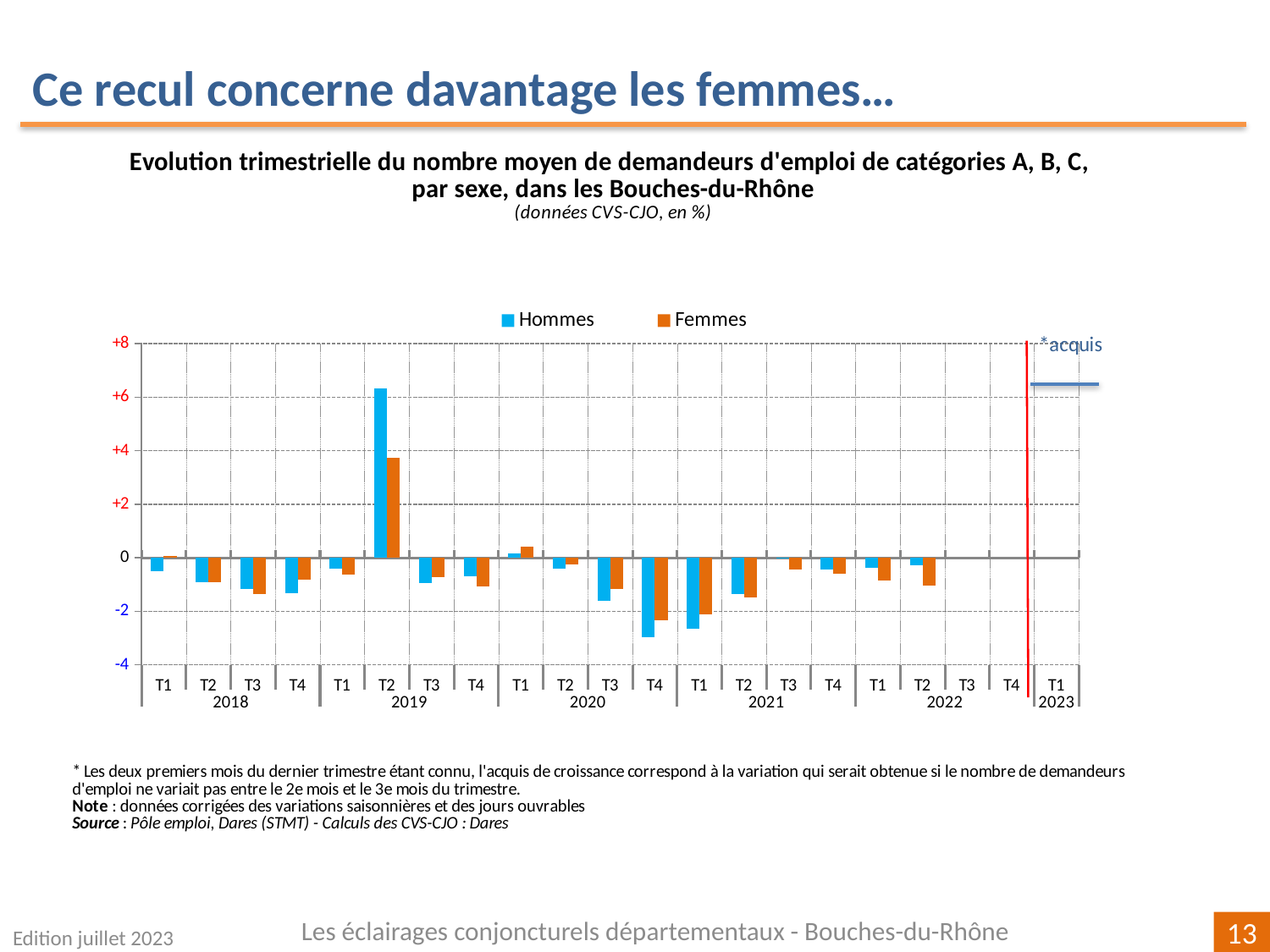
Is the value for Hommes in T4 2020 greater or less than -2? less Is the value for Femmes in T2 2019 greater or less than +2? greater How many series does the legend list? 2 What kind of chart is shown on the slide? bar chart Which series is shown in blue? Hommes In which quarter does the Hommes series reach its highest value? T2 2019 In T4 2020, which series has the lower value, Hommes or Femmes? Hommes Which series is shown in orange? Femmes Is the value for Hommes in T2 2019 greater or less than +4? greater In which quarter does the Hommes series reach its lowest value? T4 2020 In which quarter does the Femmes series reach its highest value? T2 2019 In T2 2019, which series has the larger value, Hommes or Femmes? Hommes